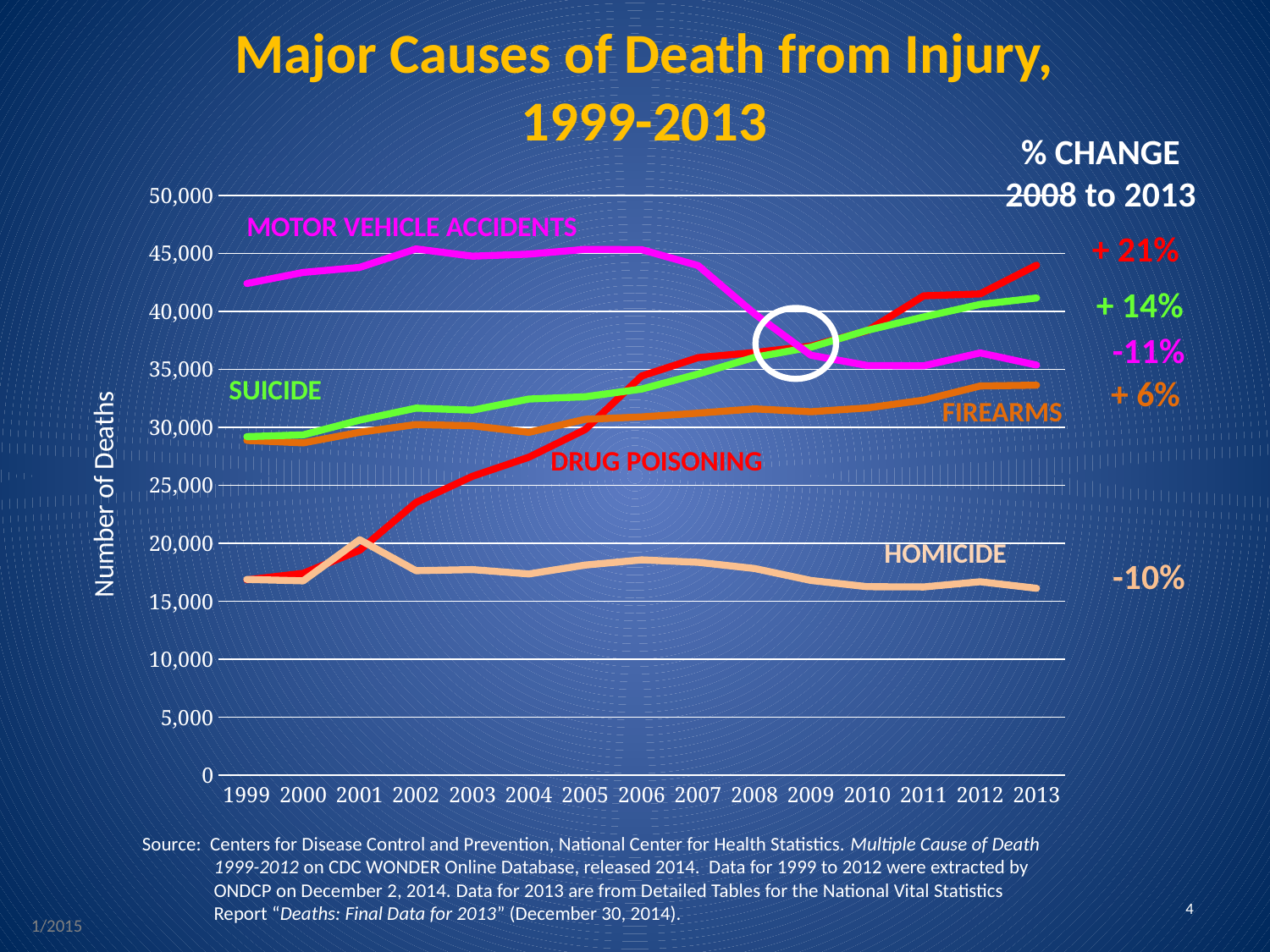
Which cause of death had the highest number of deaths in 1999? Motor vehicle accidents How many causes of death are plotted as lines on the chart? 5 Is the number of homicide deaths in 2013 greater or less than 20,000? less Which cause of death had the lowest number of deaths in 2013? Homicide Does the number of drug poisoning deaths rise or fall from 1999 to 2013? Rise What kind of chart is shown on the slide? Line chart Does the number of motor vehicle accident deaths rise or fall from 2007 to 2013? Fall How many years are shown along the x axis of the chart? 15 In 2013, which is larger: the number of suicide deaths or the number of firearms deaths? Suicide What is the percent change from 2008 to 2013 shown for homicide? -10% What is the percent change from 2008 to 2013 shown for drug poisoning? + 21% Is the number of drug poisoning deaths in 2013 greater or less than 40,000? greater